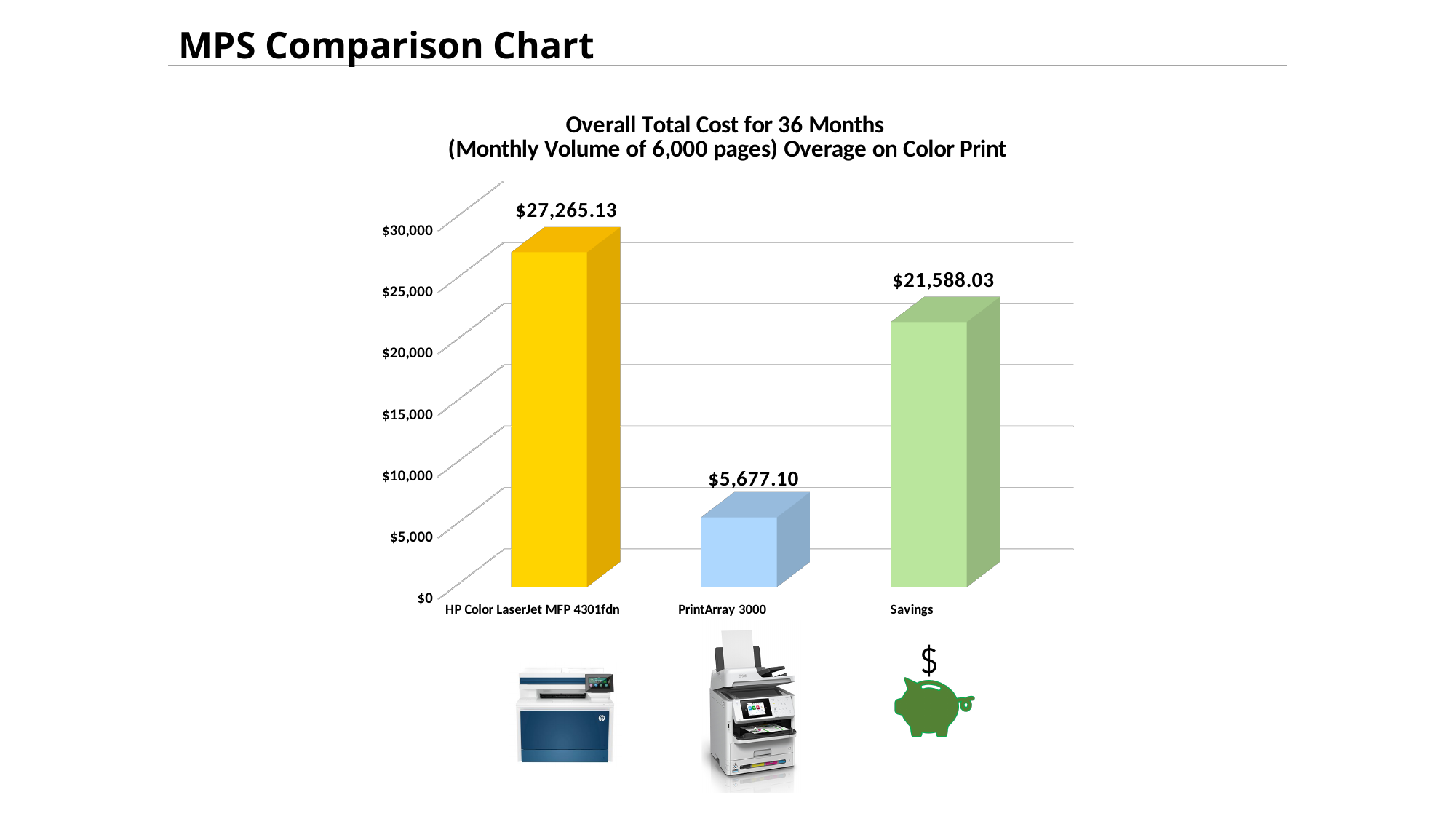
Which is larger, the value for Savings or the value for PrintArray 3000? Savings What is the value for PrintArray 3000? $5,677.10 What is the difference between the HP Color LaserJet MFP 4301fdn value and the PrintArray 3000 value? $21,588.03 What is the value for Savings? $21,588.03 Which category has the lowest value? PrintArray 3000 What kind of chart is shown on the slide? bar chart What is the value for HP Color LaserJet MFP 4301fdn? $27,265.13 What is the title of the chart? Overall Total Cost for 36 Months (Monthly Volume of 6,000 pages) Overage on Color Print Is the value for Savings greater or less than $20,000? greater Is the value for PrintArray 3000 greater or less than $10,000? less How many categories are shown on the chart? 3 Which category has the highest value? HP Color LaserJet MFP 4301fdn